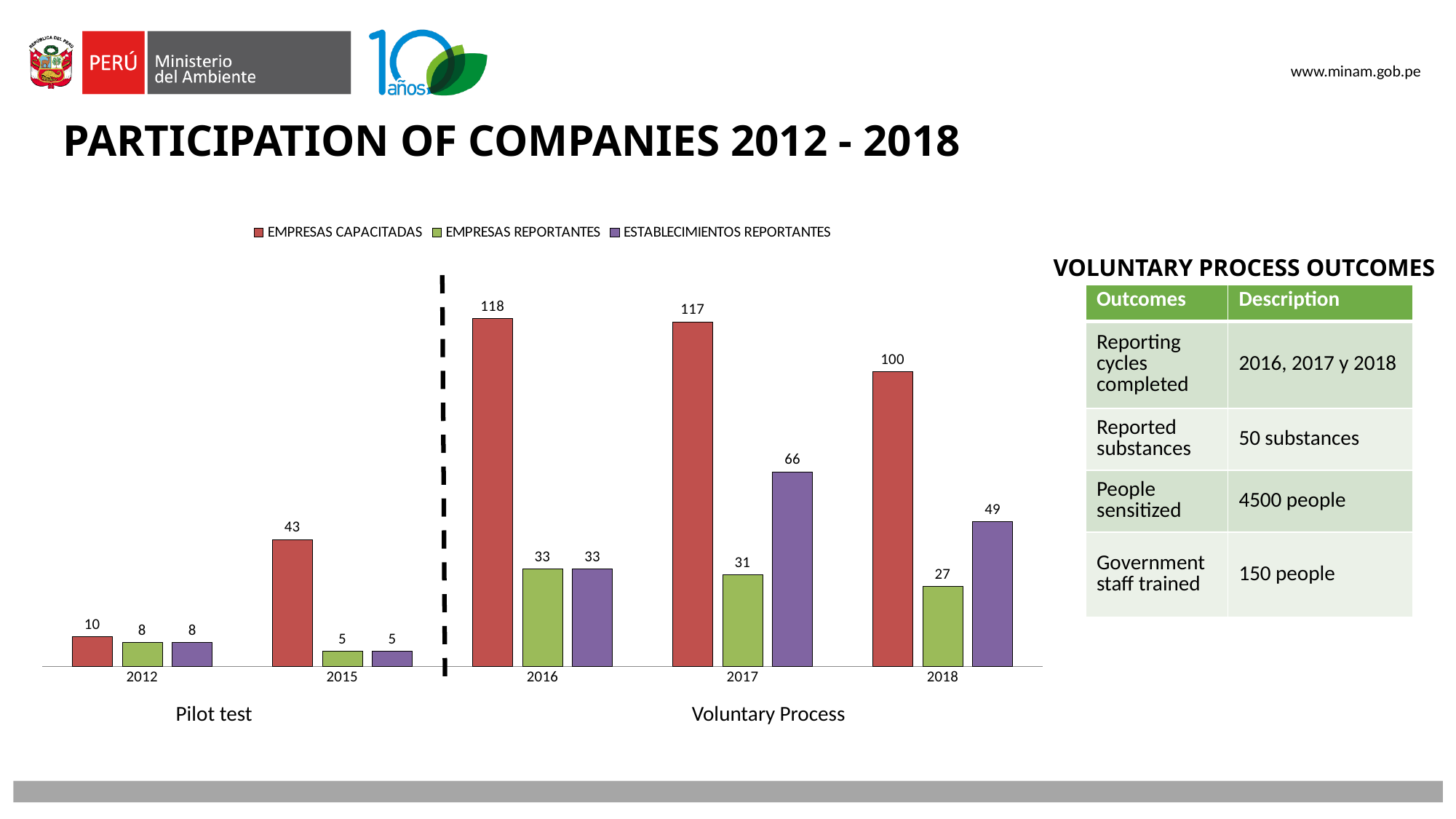
In which year is EMPRESAS CAPACITADAS highest? 2016 In which year is EMPRESAS REPORTANTES lowest? 2015 How many years are shown on the x axis? 5 What is the value of EMPRESAS CAPACITADAS for 2016? 118 What is the value of ESTABLECIMIENTOS REPORTANTES for 2017? 66 What is the value of EMPRESAS REPORTANTES for 2018? 27 Which colour represents ESTABLECIMIENTOS REPORTANTES in the legend? Purple What is the difference between EMPRESAS CAPACITADAS in 2016 and in 2018? 18 What kind of chart is shown on the slide? Bar chart Which is larger: ESTABLECIMIENTOS REPORTANTES in 2017 or in 2018? 2017 Does EMPRESAS CAPACITADAS rise or fall from 2016 to 2018? Fall How many series does the legend list? 3